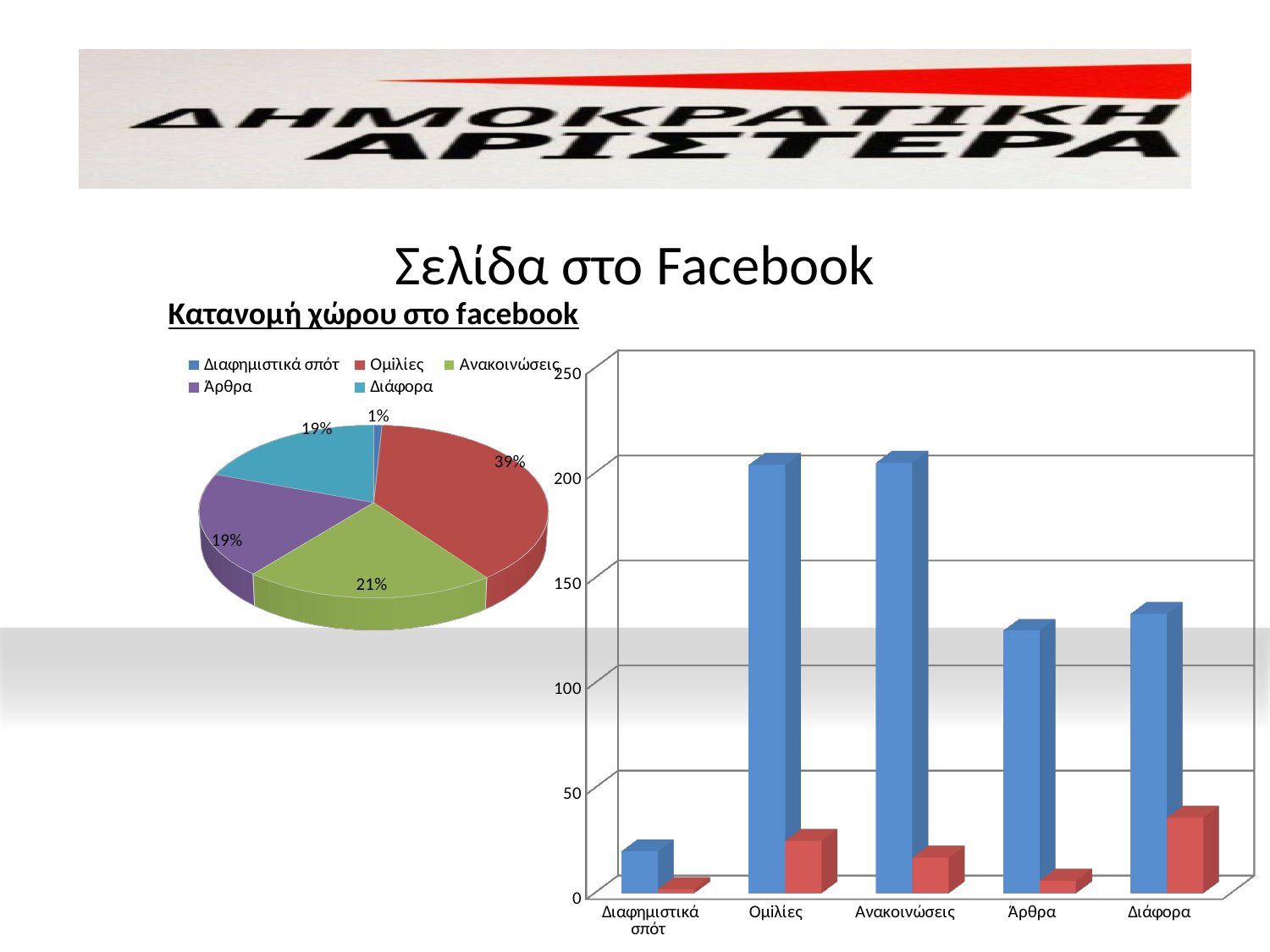
On the pie chart, what share does Ομιλίες have? 39% On the bar chart on the right, which category has the lowest blue bar? Διαφημιστικά σπότ How many categories does the pie chart's legend list? 5 On the pie chart, what is the difference in percentage points between Ομιλίες and Ανακοινώσεις? 18 On the bar chart on the right, is the blue bar for Άρθρα greater or less than 100? greater On the bar chart on the right, is the blue bar for Ομιλίες greater or less than 150? greater What kind of chart is the chart on the right side of the slide? bar chart On the pie chart, what share does Διαφημιστικά σπότ have? 1% On the pie chart, which category has the largest slice? Ομιλίες On the pie chart, what share does Ανακοινώσεις have? 21% On the bar chart on the right, is the blue bar for Διαφημιστικά σπότ greater or less than 50? less On the pie chart, which category has the smallest slice? Διαφημιστικά σπότ